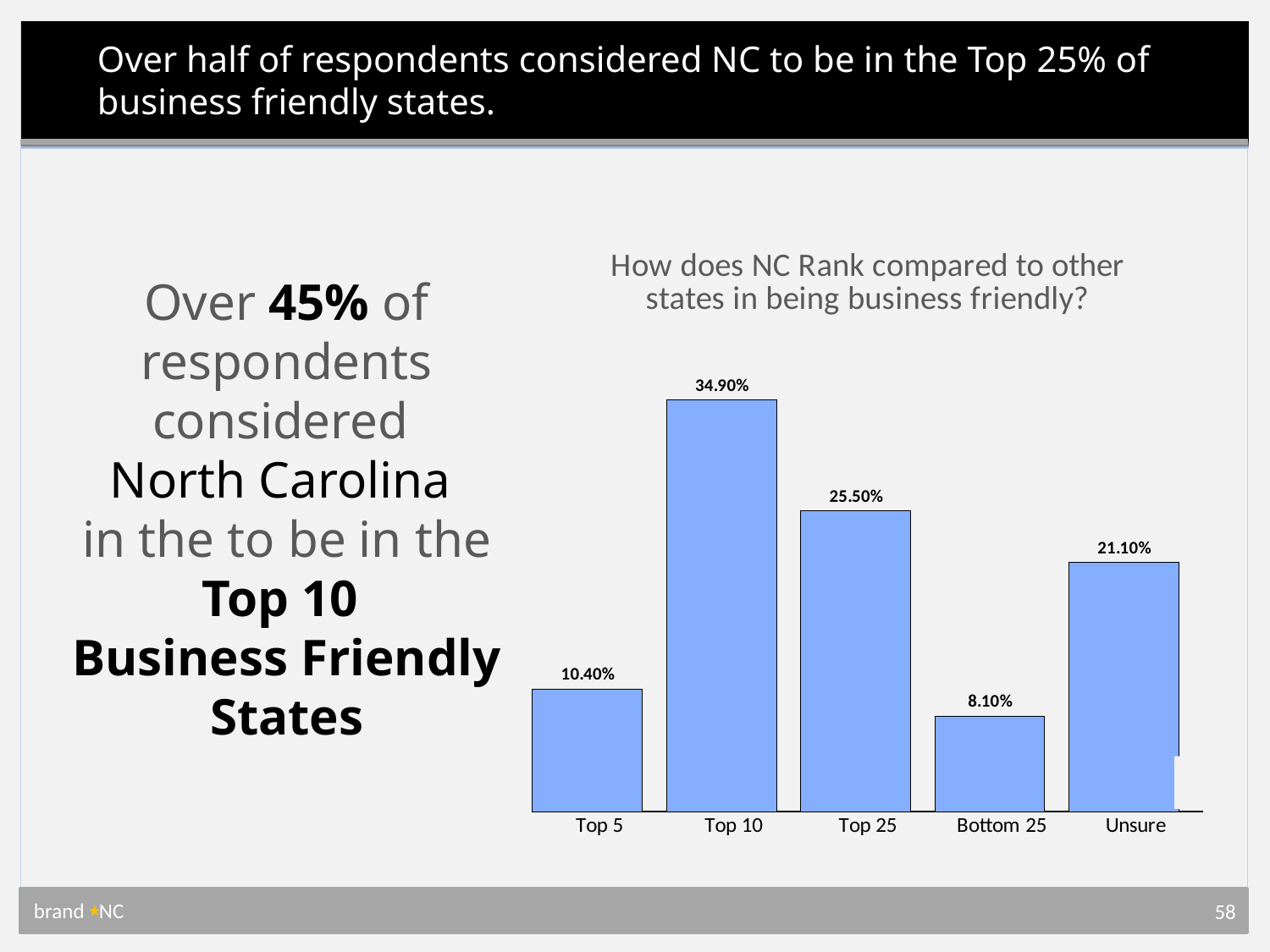
What is the difference between the Unsure and Top 5 values? 10.70% Which category has the lowest value? Bottom 25 What is the title of the chart? How does NC Rank compared to other states in being business friendly? What kind of chart is shown on the slide? Bar chart Which is larger, the value for Top 25 or the value for Unsure? Top 25 What percentage of respondents ranked NC in the Top 10? 34.90% What percentage of respondents ranked NC in the Bottom 25? 8.10% What percentage of respondents ranked NC in the Top 5? 10.40% How many categories are shown on the x axis? 5 Which category has the highest value? Top 10 What is the difference between the Top 10 and Top 25 values? 9.40% What percentage of respondents were Unsure? 21.10%